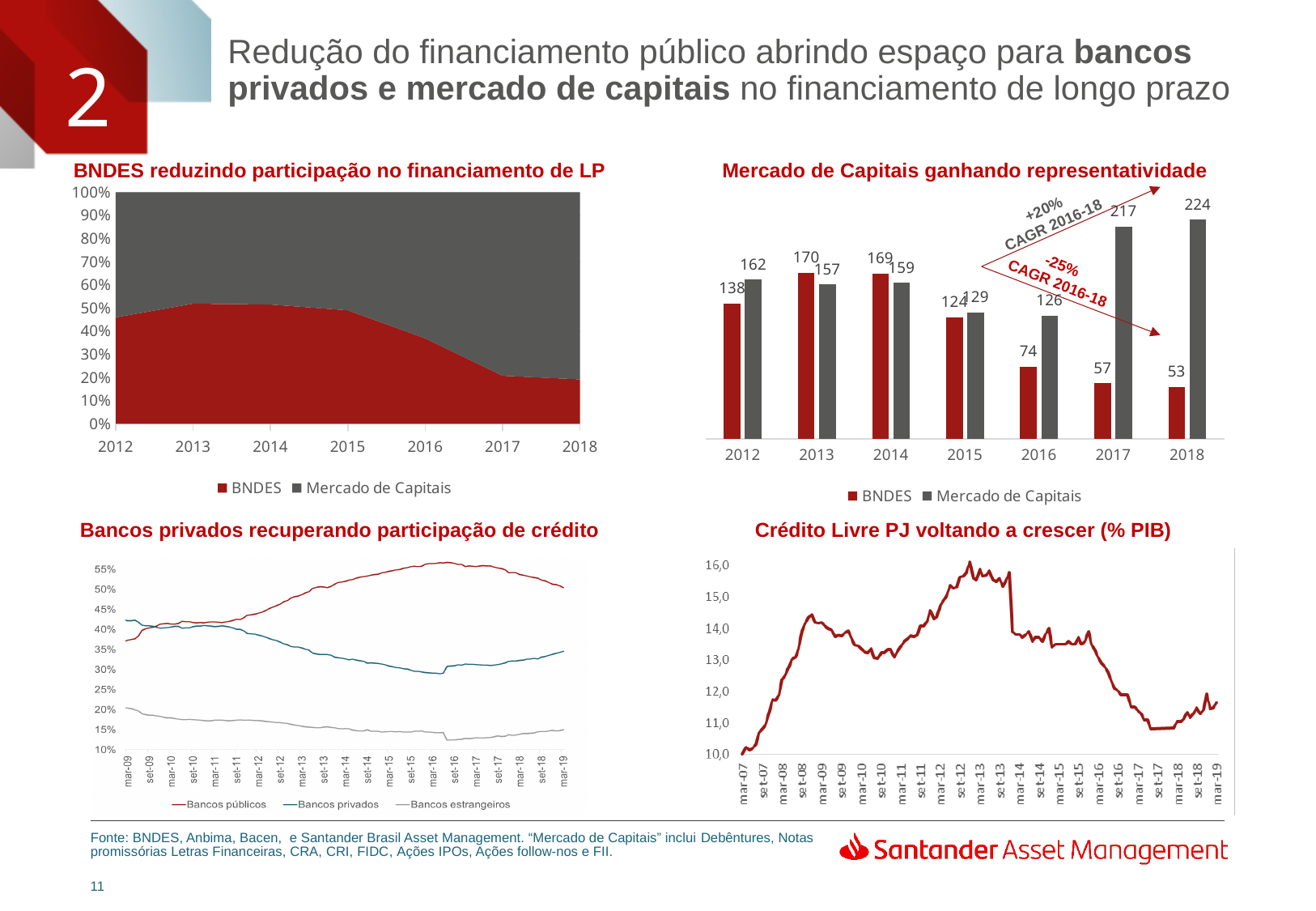
In the chart titled "Mercado de Capitais ganhando representatividade", what is the BNDES value for 2012? 138 In the chart titled "Bancos privados recuperando participação de crédito", which series has the highest value at mar-19? Bancos públicos In the chart titled "Mercado de Capitais ganhando representatividade", what is the difference between the Mercado de Capitais and BNDES values in 2017? 160 In the chart titled "Mercado de Capitais ganhando representatividade", which series has the larger value in 2013, BNDES or Mercado de Capitais? BNDES How many series does the legend list in the chart titled "Bancos privados recuperando participação de crédito"? 3 In the chart titled "Mercado de Capitais ganhando representatividade", which year has the highest Mercado de Capitais value? 2018 What kind of chart is the one titled "BNDES reduzindo participação no financiamento de LP"? Stacked area chart In the chart titled "BNDES reduzindo participação no financiamento de LP", is the BNDES share in 2018 greater or less than 30%? less In the chart titled "Crédito Livre PJ voltando a crescer (% PIB)", is the value at mar-13 greater or less than 15,0? greater In the chart titled "Mercado de Capitais ganhando representatividade", which year has the lowest BNDES value? 2018 In the chart titled "Mercado de Capitais ganhando representatividade", what is the Mercado de Capitais value for 2018? 224 In the chart titled "Mercado de Capitais ganhando representatividade", how many years are shown on the x axis? 7